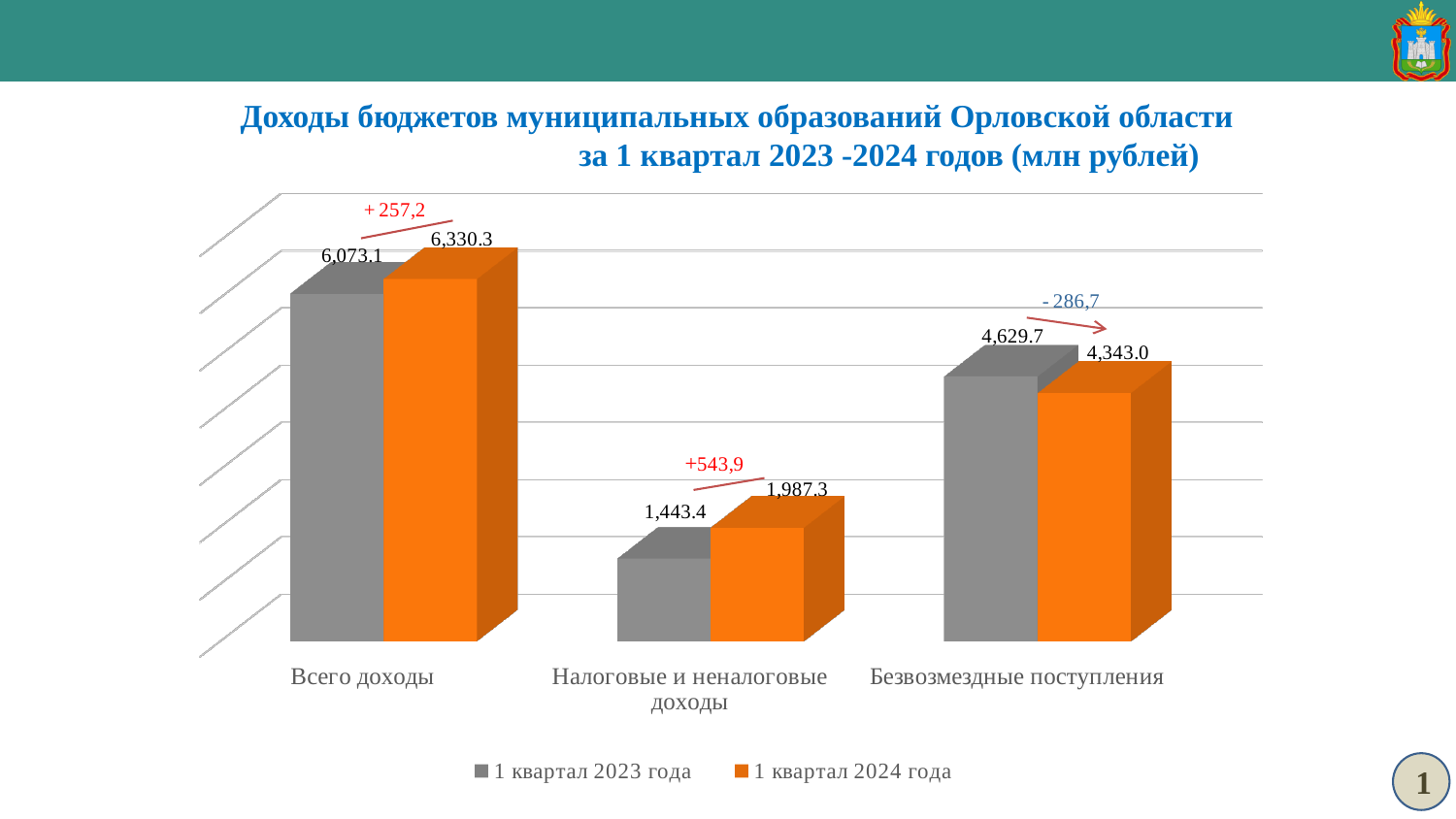
Which category has the lowest value in 1 квартал 2023 года? Налоговые и неналоговые доходы What is the value for Безвозмездные поступления in 1 квартал 2024 года? 4,343.0 What is the value for Всего доходы in 1 квартал 2024 года? 6,330.3 How many categories are shown on the x axis? 3 How many series does the legend list? 2 What is the value for Налоговые и неналоговые доходы in 1 квартал 2023 года? 1,443.4 What kind of chart is shown on the slide? Bar chart What is the value for Безвозмездные поступления in 1 квартал 2023 года? 4,629.7 Which category has the highest value in 1 квартал 2024 года? Всего доходы What is the difference between the 1 квартал 2024 года and 1 квартал 2023 года values for Налоговые и неналоговые доходы? 543.9 What change is annotated above the bars for Всего доходы? +257,2 Which is larger for Безвозмездные поступления: the 1 квартал 2023 года value or the 1 квартал 2024 года value? 1 квартал 2023 года